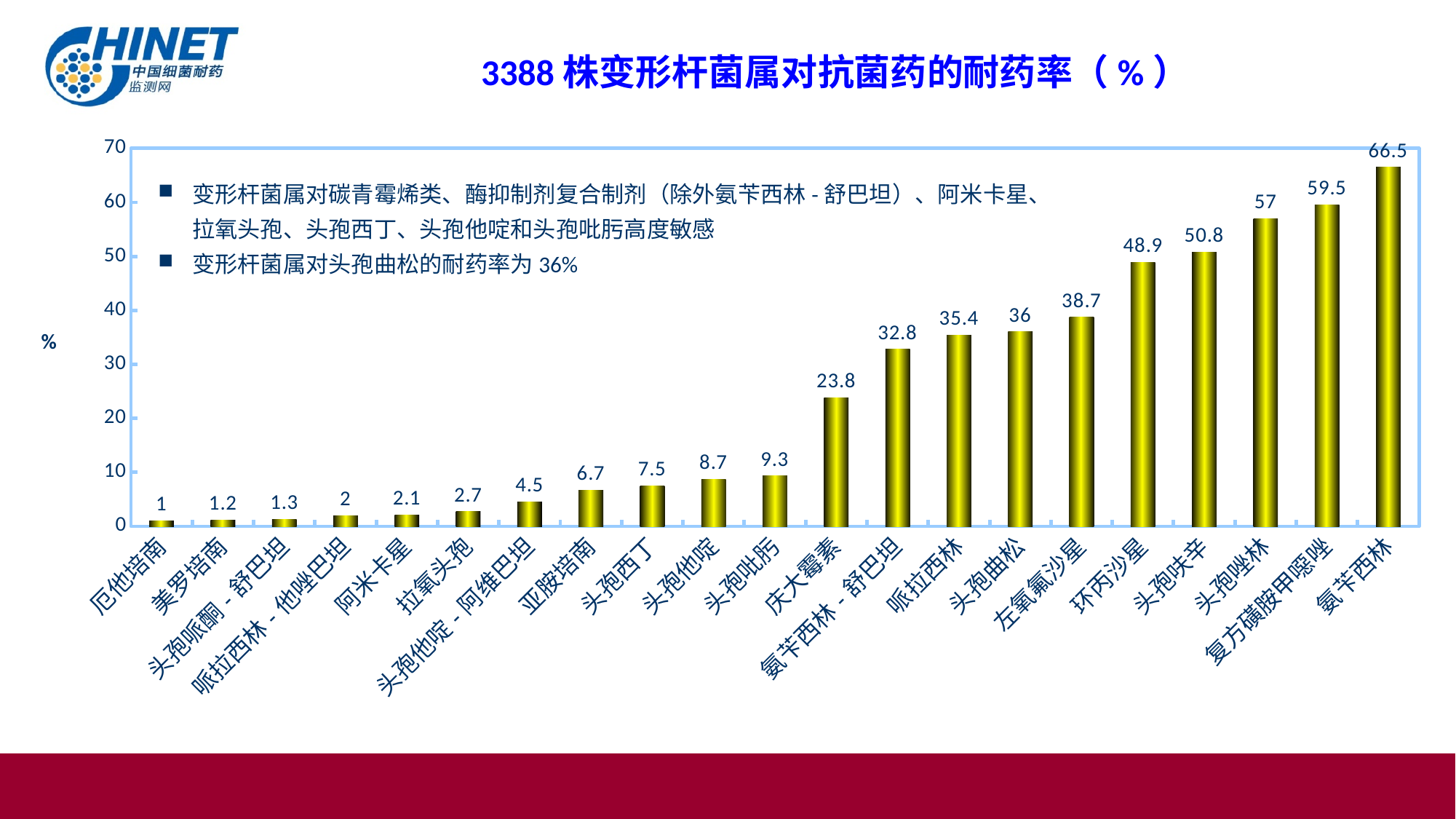
What is the resistance rate for 头孢曲松? 36 Which antibiotic has the lowest resistance rate? 厄他培南 What is the resistance rate for 庆大霉素? 23.8 How many antibiotics are shown on the x axis? 21 What is the resistance rate for 氨苄西林? 66.5 What is the difference between the resistance rates for 复方磺胺甲噁唑 and 头孢唑林? 2.5 What is the resistance rate for 头孢他啶-阿维巴坦? 4.5 What kind of chart is shown on the slide? bar chart Do the values rise or fall from left to right along the x axis? rise Is the value for 头孢呋辛 greater or less than 50? greater Which has a higher resistance rate, 环丙沙星 or 左氧氟沙星? 环丙沙星 Which antibiotic has the highest resistance rate? 氨苄西林